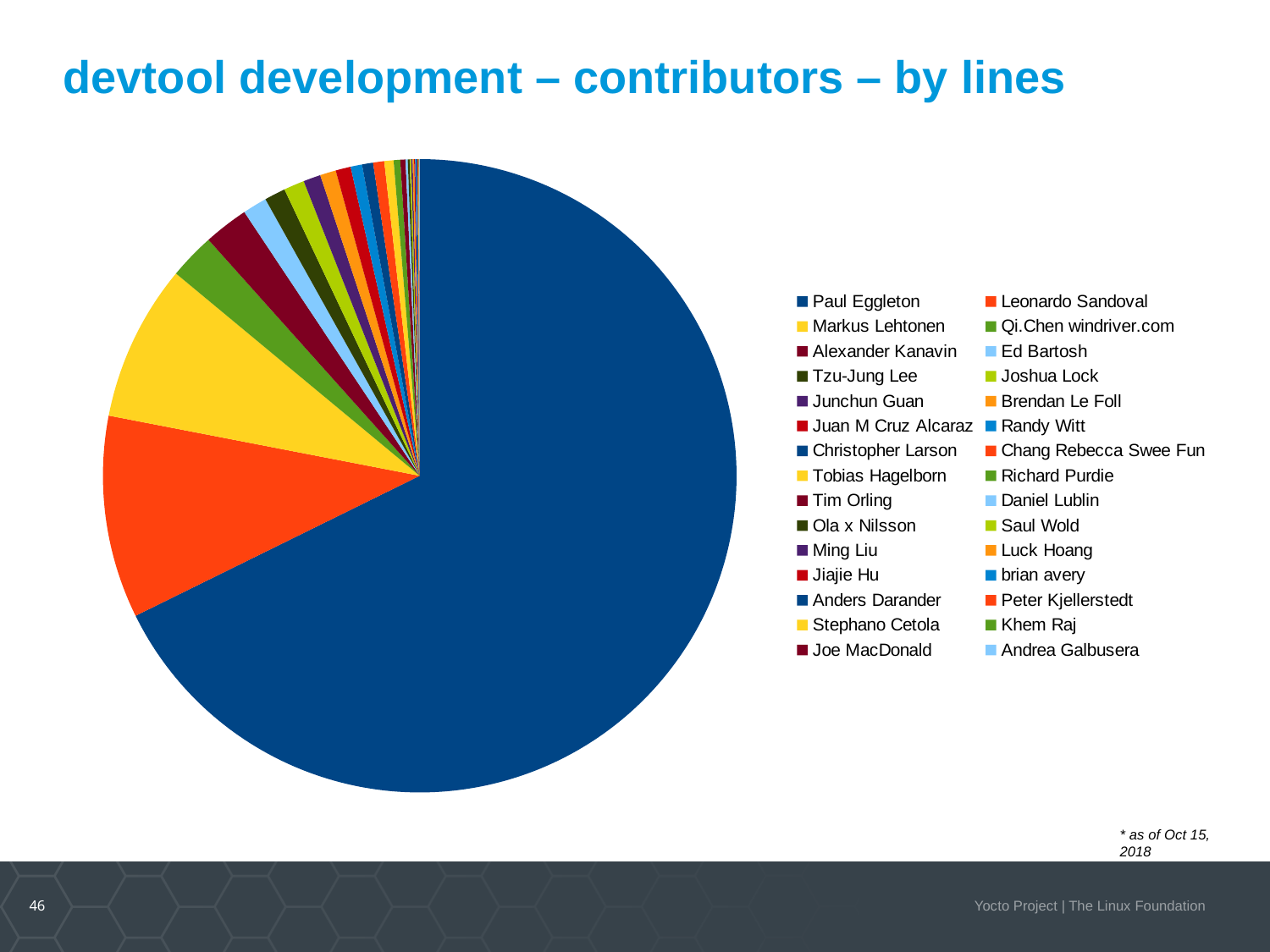
How many contributors are listed in the chart legend? 30 Which slice is larger, Markus Lehtonen's or Qi.Chen windriver.com's? Markus Lehtonen Which contributor has the largest slice of the pie? Paul Eggleton Which slice is larger, Paul Eggleton's or Leonardo Sandoval's? Paul Eggleton What is the title of the chart on the slide? devtool development – contributors – by lines Which slice is larger, Leonardo Sandoval's or Markus Lehtonen's? Leonardo Sandoval Does Paul Eggleton's slice account for more or less than half of the pie? more What kind of chart is shown on the slide? pie chart What colour is the slice for Paul Eggleton? dark blue Which contributor has the second-largest slice of the pie? Leonardo Sandoval